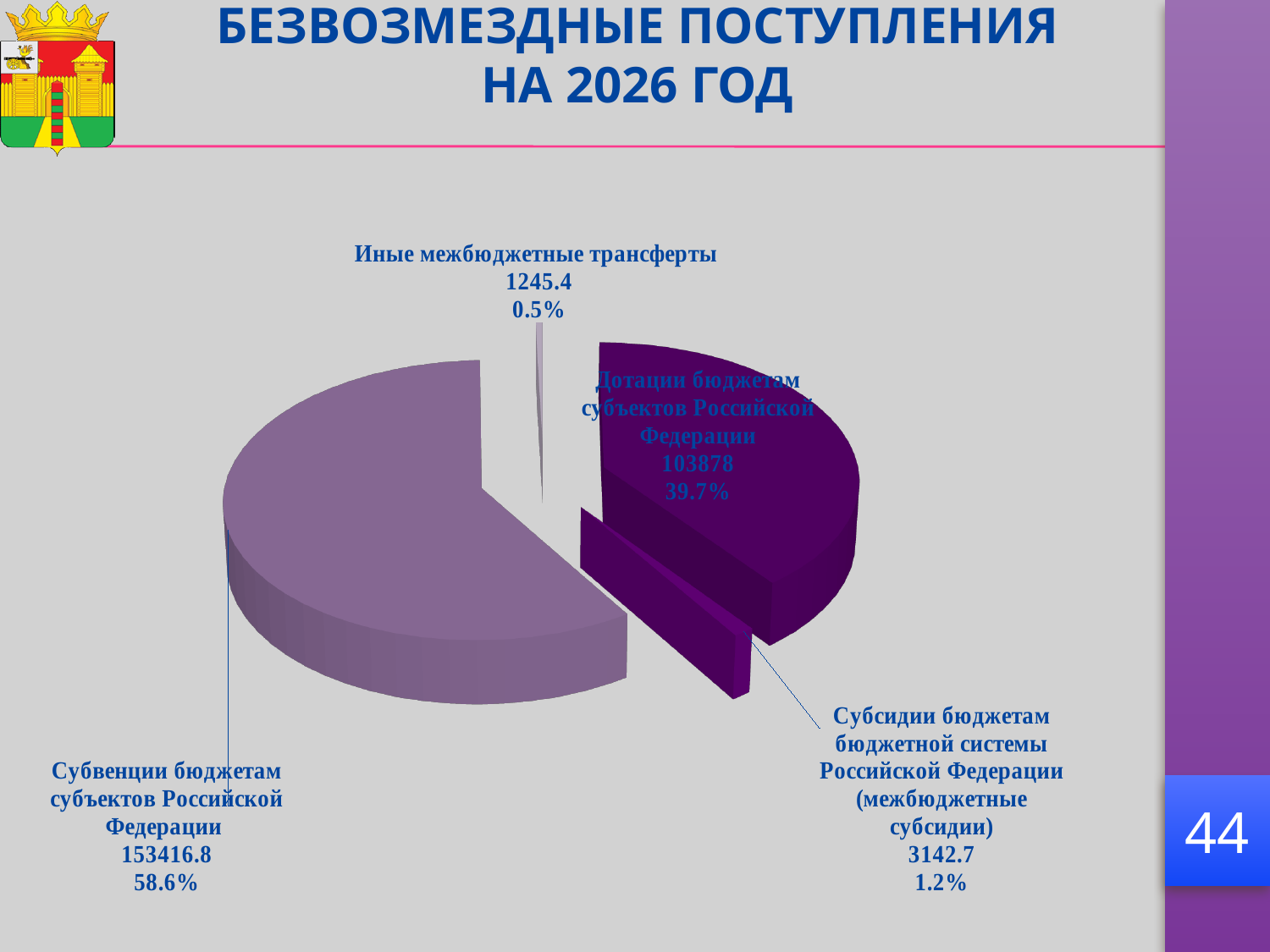
Which is larger: the value for Субсидии (межбюджетные субсидии) or the value for Иные межбюджетные трансферты? Субсидии (межбюджетные субсидии) What is the value for Субсидии бюджетам бюджетной системы Российской Федерации (межбюджетные субсидии)? 3142.7 Which category has the smallest slice of the pie? Иные межбюджетные трансферты What is the value for Субвенции бюджетам субъектов Российской Федерации? 153416.8 What is the value for Дотации бюджетам субъектов Российской Федерации? 103878 What share of the pie does Субвенции бюджетам субъектов Российской Федерации represent? 58.6% What kind of chart is shown on the slide? Pie chart What share of the pie does Дотации бюджетам субъектов Российской Федерации represent? 39.7% Which category has the largest slice of the pie? Субвенции бюджетам субъектов Российской Федерации How many slices does the pie chart have? 4 What is the difference between the values for Субвенции бюджетам субъектов Российской Федерации and Дотации бюджетам субъектов Российской Федерации? 49538.8 What is the value for Иные межбюджетные трансферты? 1245.4